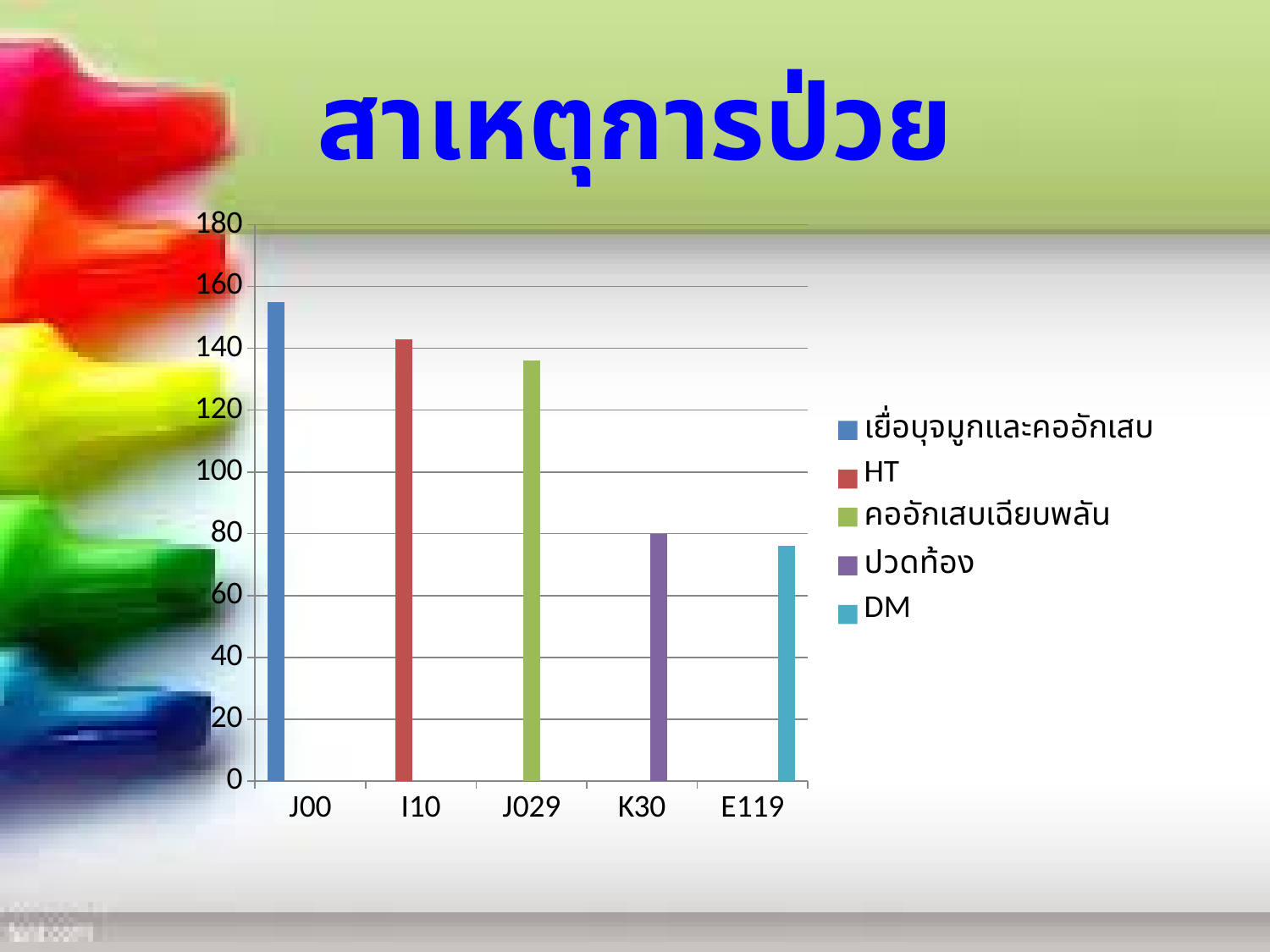
Which category has the highest bar in the chart? J00 What is the title of the slide containing the chart? สาเหตุการป่วย Which is larger, the value for J00 or the value for I10? J00 What kind of chart is shown on the slide? bar chart Do the bar values rise or fall from left to right along the x axis? fall Is the value for J00 greater or less than 140? greater Is the value for J029 greater or less than 140? less How many entries does the chart's legend list? 5 Is the value for E119 greater or less than 100? less How many categories are shown on the x axis of the chart? 5 Which is larger, the value for J029 or the value for K30? J029